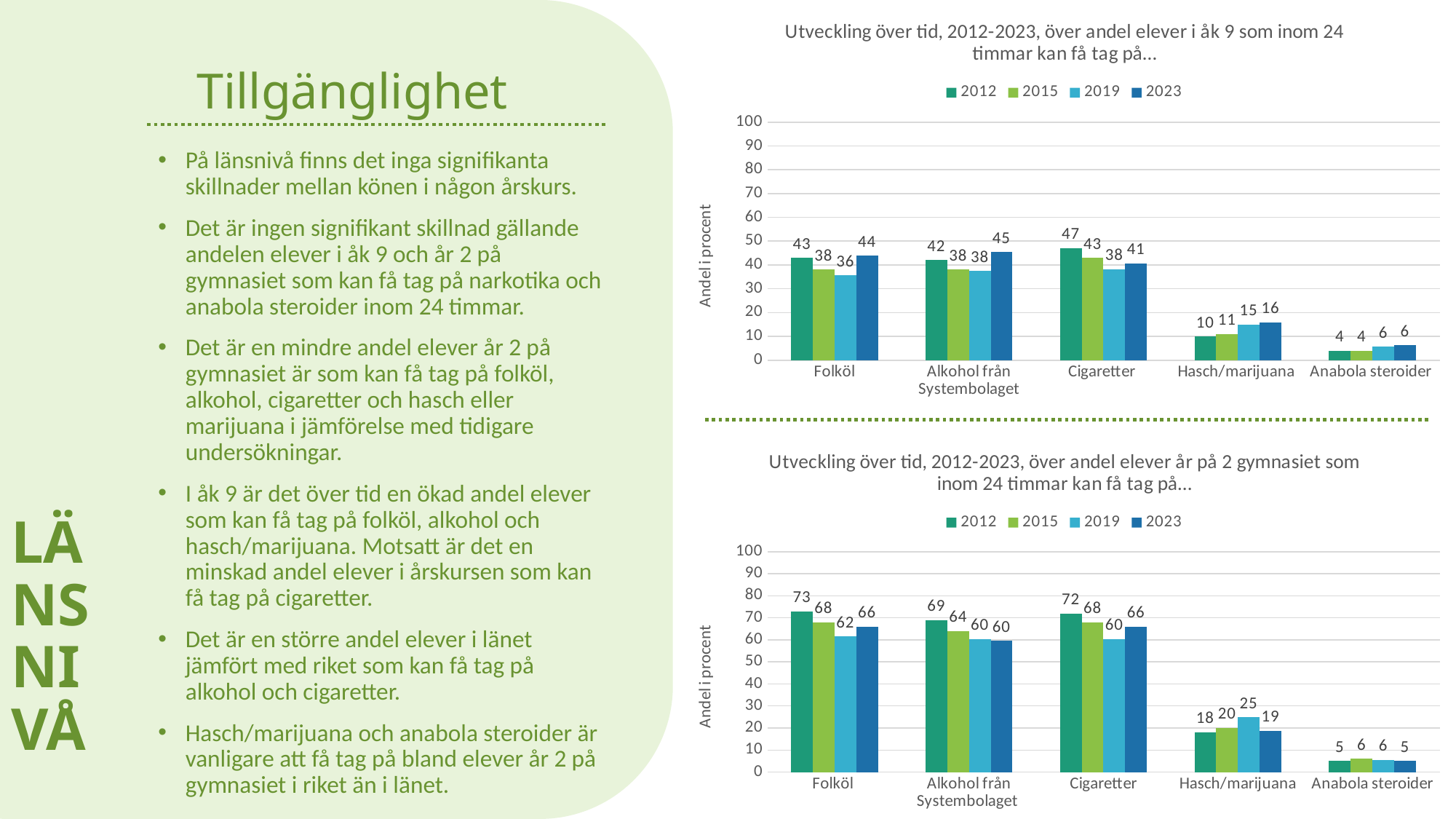
In the top chart (åk 9), what is the difference between the 2012 and 2023 values for Cigaretter? 6 How many series does the legend of the bottom chart (år 2 på gymnasiet) list? 4 In the bottom chart (år 2 på gymnasiet), what is the value for Folköl in 2012? 73 In the bottom chart (år 2 på gymnasiet), which category has the highest value in 2012? Folköl What kind of chart is the top chart (åk 9)? bar chart In the top chart (åk 9), what is the value for Cigaretter in 2012? 47 In the top chart (åk 9), which category has the lowest value in 2023? Anabola steroider In the top chart (åk 9), what is the value for Hasch/marijuana in 2023? 16 In the top chart (åk 9), is the 2023 value for Folköl or the 2023 value for Cigaretter larger? Folköl In the top chart (åk 9), do the values for Hasch/marijuana rise or fall from 2012 to 2023? rise In the bottom chart (år 2 på gymnasiet), what is the value for Hasch/marijuana in 2019? 25 In the bottom chart (år 2 på gymnasiet), what is the difference between the 2012 and 2019 values for Folköl? 11